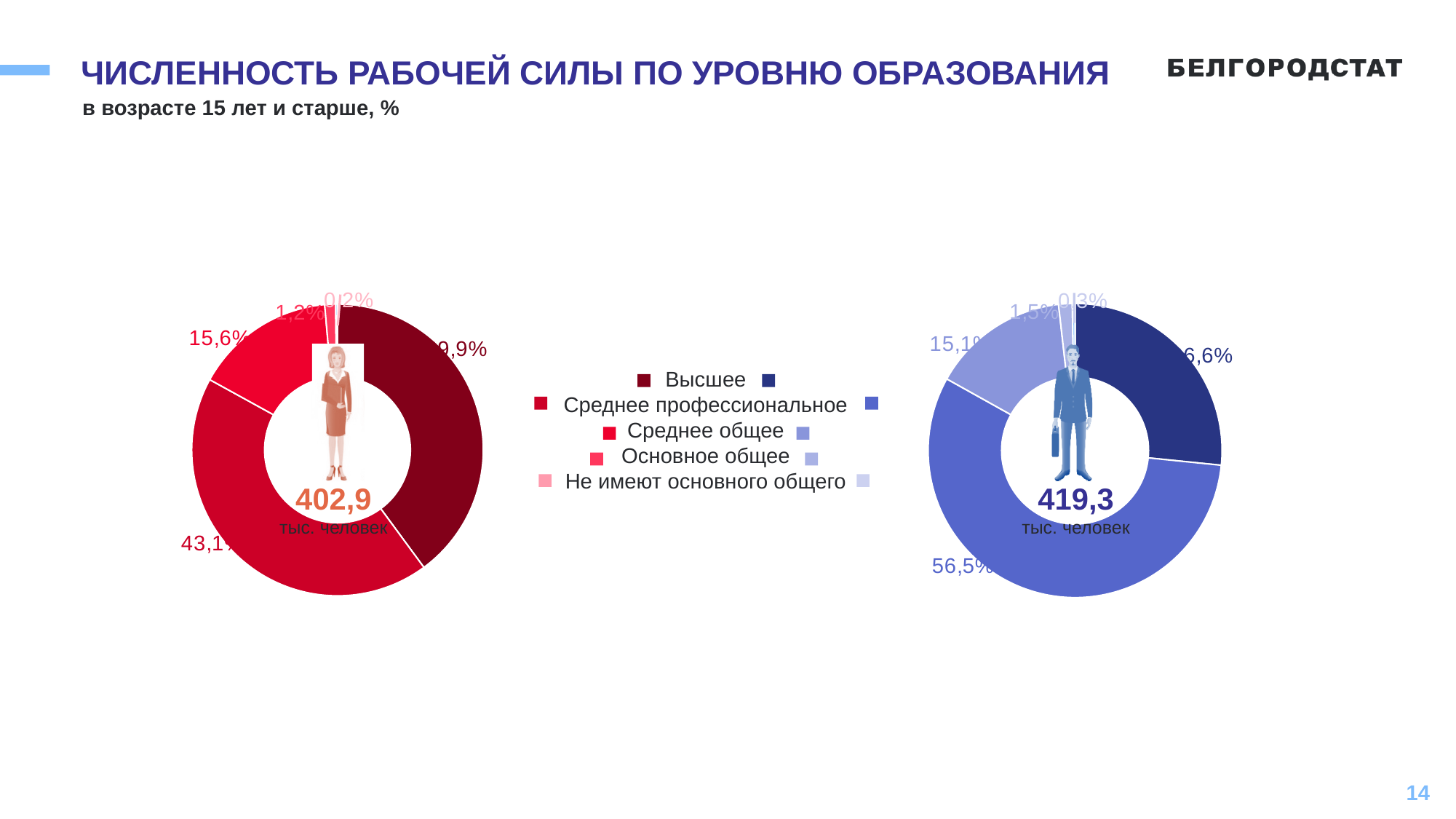
In the left chart (402,9 тыс. человек), what is the share for Не имеют основного общего? 0,2% What total is shown in the centre of the right chart? 419,3 тыс. человек What kind of chart is the left chart with the total 402,9 тыс. человек? doughnut chart In the right chart (419,3 тыс. человек), what is the share for Не имеют основного общего? 0,3% In the left chart (402,9 тыс. человек), which category has the smallest slice? Не имеют основного общего In the right chart (419,3 тыс. человек), what is the share for Среднее общее? 15,1% In the left chart (402,9 тыс. человек), what is the share for Среднее профессиональное? 43,1% In the left chart (402,9 тыс. человек), what is the share for Среднее общее? 15,6% In the right chart (419,3 тыс. человек), which category has the largest slice? Среднее профессиональное How many education categories does the legend list? 5 In the right chart (419,3 тыс. человек), what is the share for Среднее профессиональное? 56,5% In the left chart (402,9 тыс. человек), what is the share for Основное общее? 1,2%